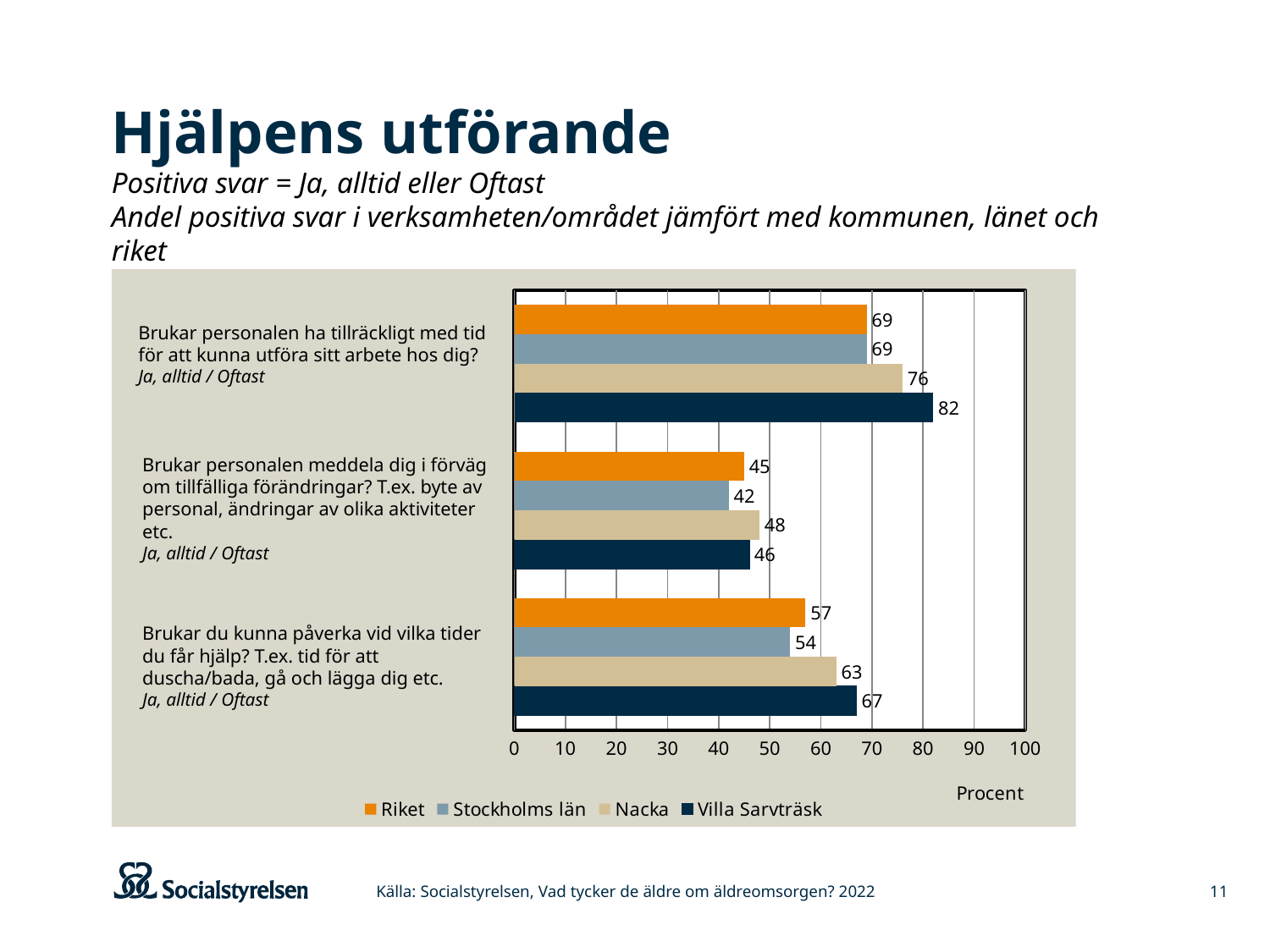
Which is larger on the question "Brukar personalen meddela dig i förväg om tillfälliga förändringar?": Riket or Villa Sarvträsk? Villa Sarvträsk What is the value for Stockholms län on the question "Brukar du kunna påverka vid vilka tider du får hjälp?"? 54 What is the value for Nacka on the question "Brukar personalen meddela dig i förväg om tillfälliga förändringar?"? 48 What kind of chart is shown on the slide? Bar chart What unit is shown on the horizontal axis of the chart? Procent How many questions (categories) are shown in the chart? 3 Which series has the lowest value on the question "Brukar personalen meddela dig i förväg om tillfälliga förändringar?"? Stockholms län How many series does the legend list? 4 Which series has the highest value on the question "Brukar du kunna påverka vid vilka tider du får hjälp?"? Villa Sarvträsk What is the value for Villa Sarvträsk on the question "Brukar personalen ha tillräckligt med tid för att kunna utföra sitt arbete hos dig?"? 82 What is the difference between Villa Sarvträsk and Riket on the question "Brukar personalen ha tillräckligt med tid för att kunna utföra sitt arbete hos dig?"? 13 Is the value for Nacka on the question "Brukar du kunna påverka vid vilka tider du får hjälp?" greater or less than 60? greater